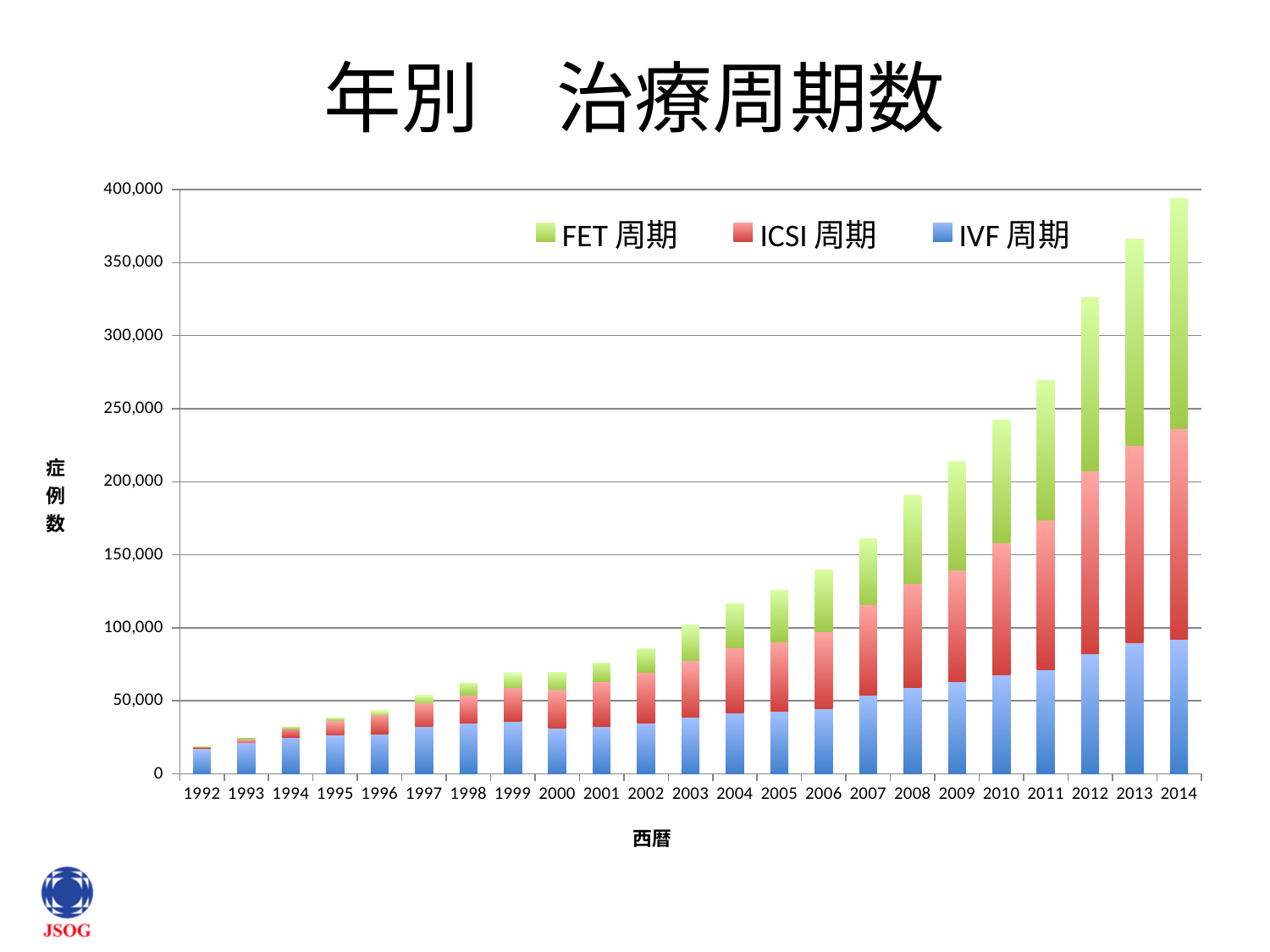
Which year has the lowest total number of treatment cycles? 1992 Is the IVF 周期 value for 2014 greater or less than 50,000? greater Which year has the highest total number of treatment cycles? 2014 Do the total treatment cycles rise or fall from 1992 to 2014? Rise In 2014, which segment is larger: FET 周期 or IVF 周期? FET 周期 How many series does the legend list? 3 Is the total value for 2010 greater or less than 200,000? greater What kind of chart is shown on the slide? Stacked bar chart How many years are shown along the x axis? 23 Is the total value for 2014 greater or less than 350,000? greater What is the title of the chart? 年別 治療周期数